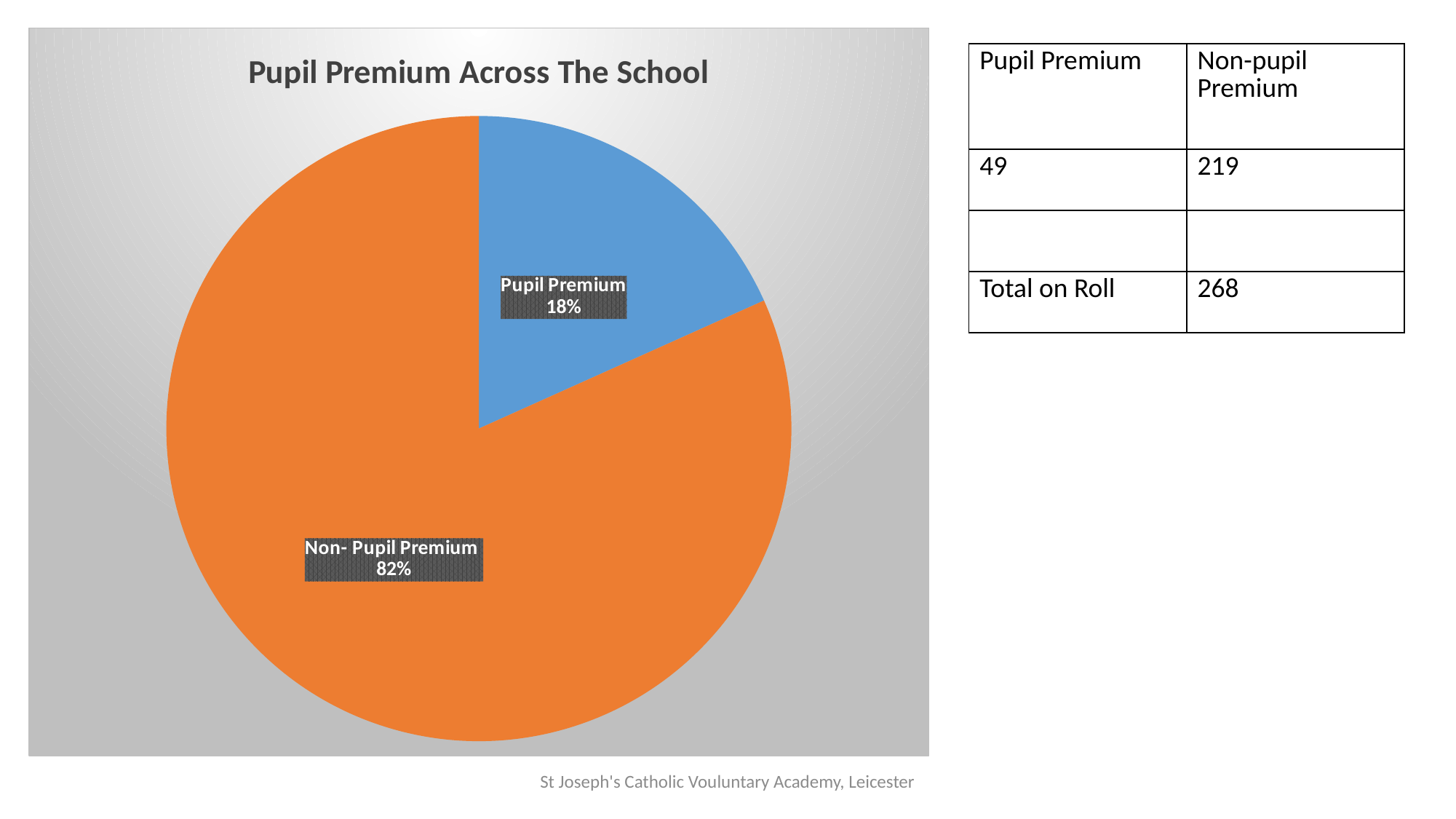
What percentage of the pie is labelled Non- Pupil Premium? 82% Which slice of the pie is the smallest? Pupil Premium Which slice of the pie is the largest? Non- Pupil Premium What is the difference in percentage points between the Non- Pupil Premium slice and the Pupil Premium slice? 64 How many slices does the pie chart have? 2 Which is larger, the Pupil Premium slice or the Non- Pupil Premium slice? Non- Pupil Premium What type of chart is shown on the slide? pie chart What colour is the Pupil Premium slice? blue What is the title of the chart? Pupil Premium Across The School What percentage of the pie is labelled Pupil Premium? 18%